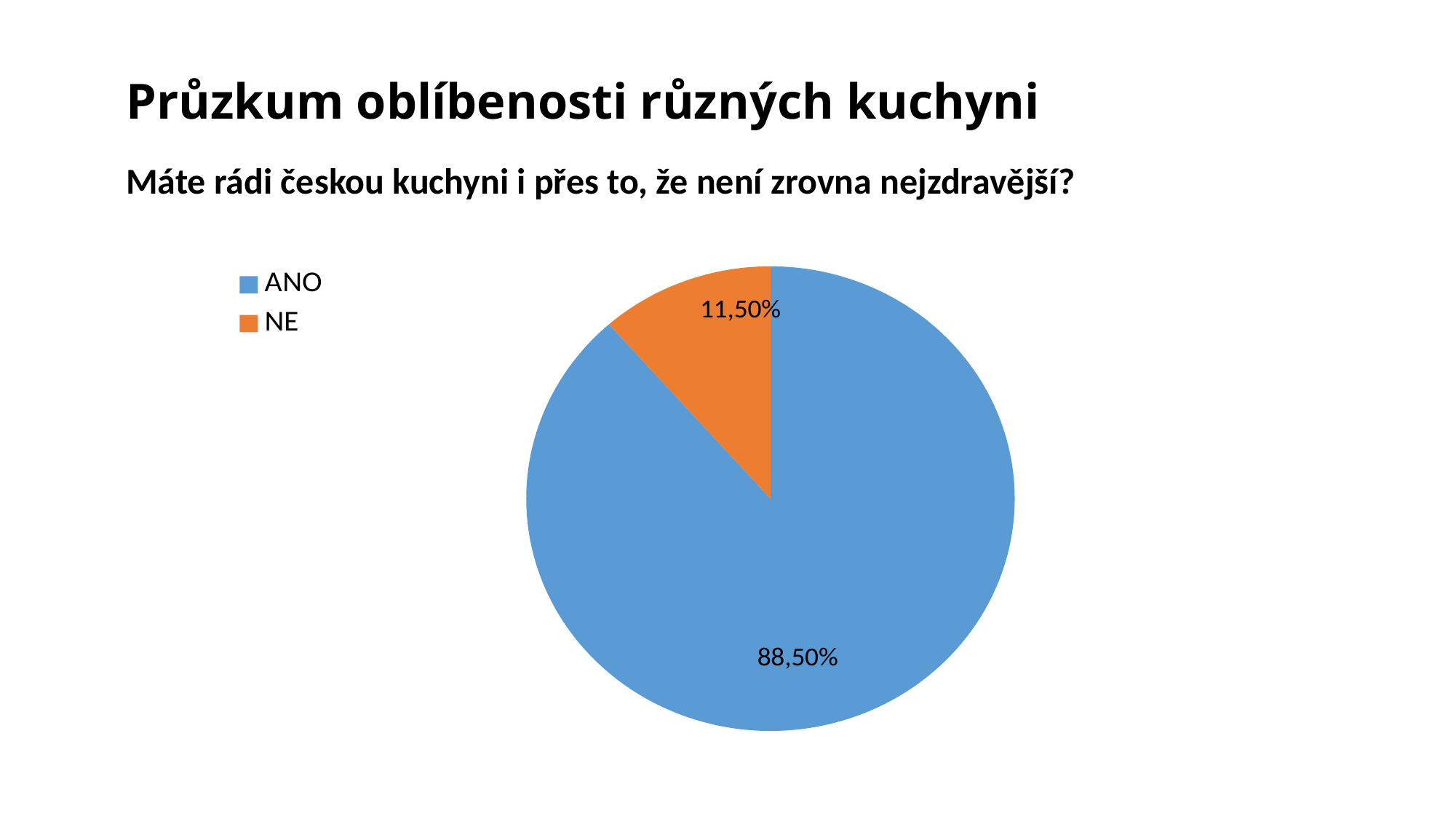
What kind of chart is shown on the slide? pie chart How many slices does the pie chart have? 2 Is the share for NE greater or less than 50%? less How many entries does the legend list? 2 What colour is the ANO slice? blue What share of the pie does NE have? 11,50% What is the difference in percentage points between the ANO and NE slices? 77 percentage points What colour is the NE slice? orange Which category has the smallest slice of the pie? NE Which category has the largest slice of the pie? ANO What share of the pie does ANO have? 88,50% Which slice is larger, ANO or NE? ANO